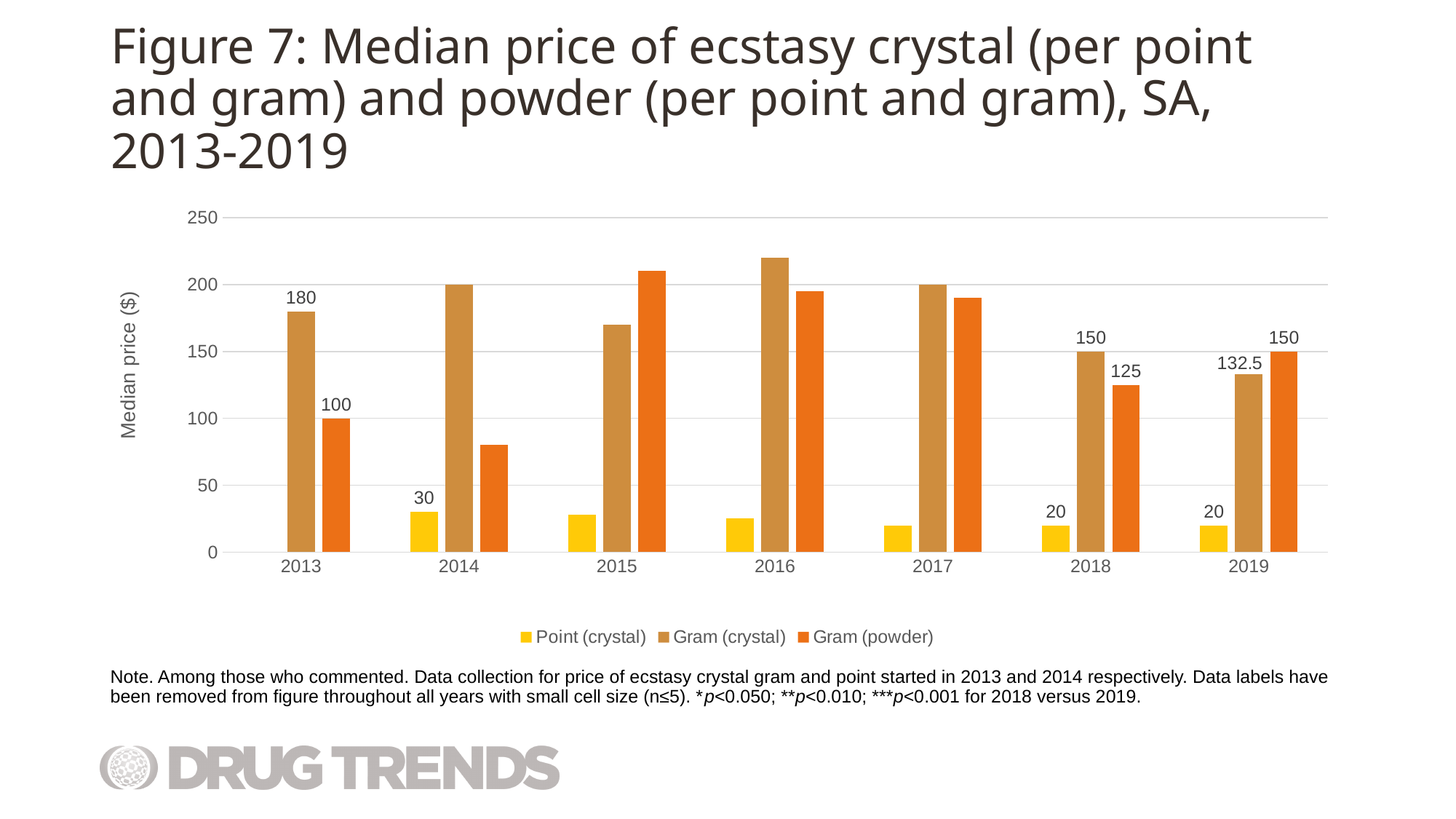
In which year is the Gram (powder) median price lowest? 2014 Is the Gram (powder) median price in 2014 greater or less than 100? less In 2019, which is higher: the Gram (crystal) or the Gram (powder) median price? Gram (powder) How many years are shown on the x axis? 7 What is the median price of Gram (powder) in 2018? 125 Is the Gram (crystal) median price in 2016 greater or less than 200? greater What is the difference between the Gram (crystal) and Gram (powder) median prices in 2013? 80 How many series does the legend list? 3 What kind of chart is shown on the slide? bar chart What is the median price of Gram (crystal) in 2019? 132.5 In which year is the Gram (crystal) median price highest? 2016 What is the median price of Gram (crystal) in 2013? 180